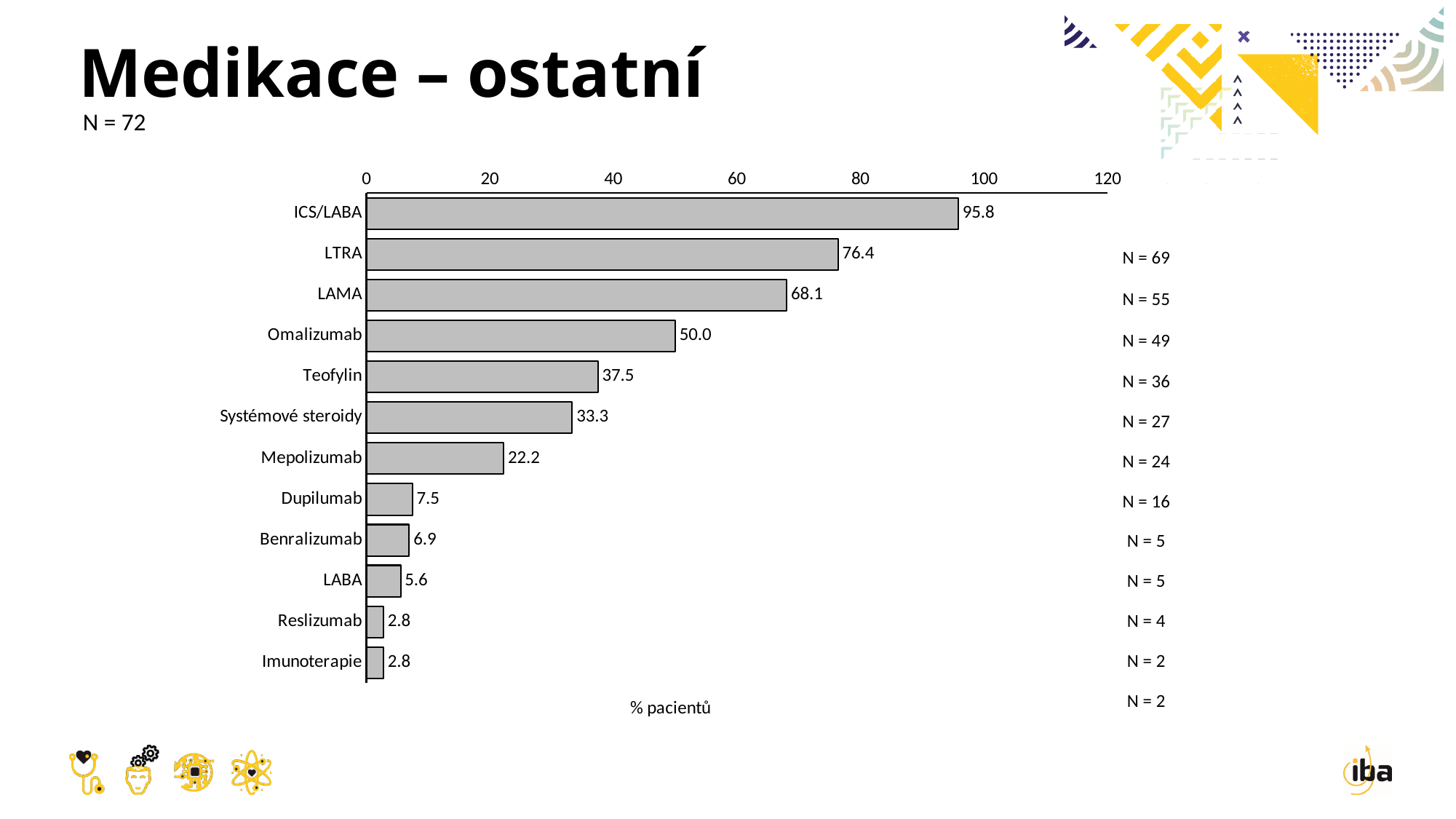
What is the label of the horizontal axis? % pacientů What is the value for Omalizumab? 50.0 Which is larger, the value for Teofylin or the value for Systémové steroidy? Teofylin What is the difference between the values for Dupilumab and LABA? 1.9 Which category has the highest value? ICS/LABA What is the value for ICS/LABA? 95.8 How many categories are shown in the chart? 12 What kind of chart is shown on the slide? bar chart Is the value for LAMA greater or less than 60? greater What is the value for Benralizumab? 6.9 What is the difference between the values for LTRA and LAMA? 8.3 What is the value for Mepolizumab? 22.2